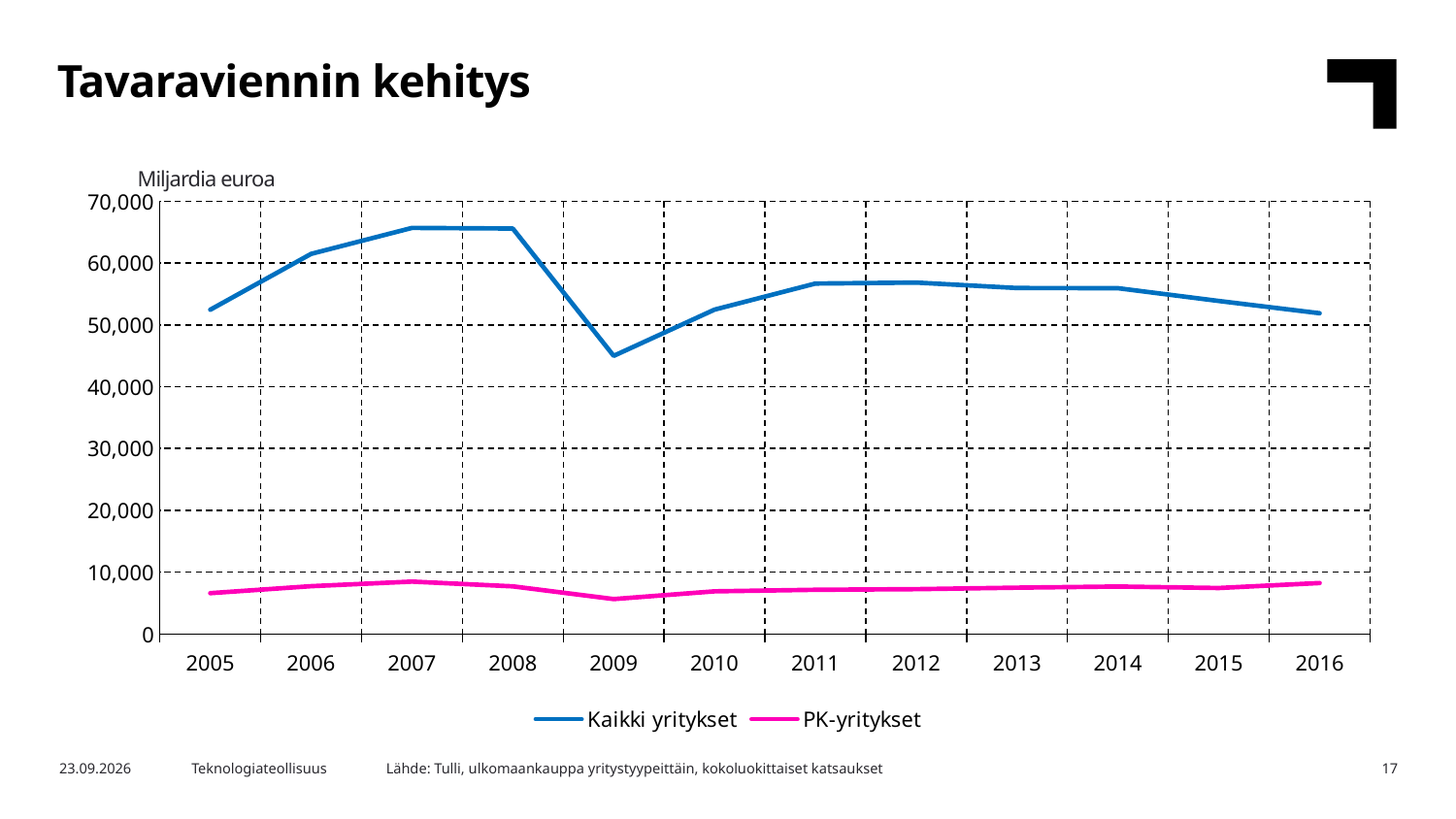
How many years are shown on the x axis? 12 Is the value for Kaikki yritykset in 2007 greater or less than 60,000? greater Which series has the larger value in 2010, Kaikki yritykset or PK-yritykset? Kaikki yritykset What unit label is shown above the y axis? Miljardia euroa What kind of chart is shown on the slide? Line chart Does the value for Kaikki yritykset rise or fall from 2012 to 2016? Fall Does the value for Kaikki yritykset rise or fall from 2005 to 2007? Rise How many series does the legend list? 2 Is the value for Kaikki yritykset in 2009 greater or less than 50,000? less In which year is the value for Kaikki yritykset lowest? 2009 Is the value for PK-yritykset in 2007 greater or less than 10,000? less What is the title of the chart? Tavaraviennin kehitys